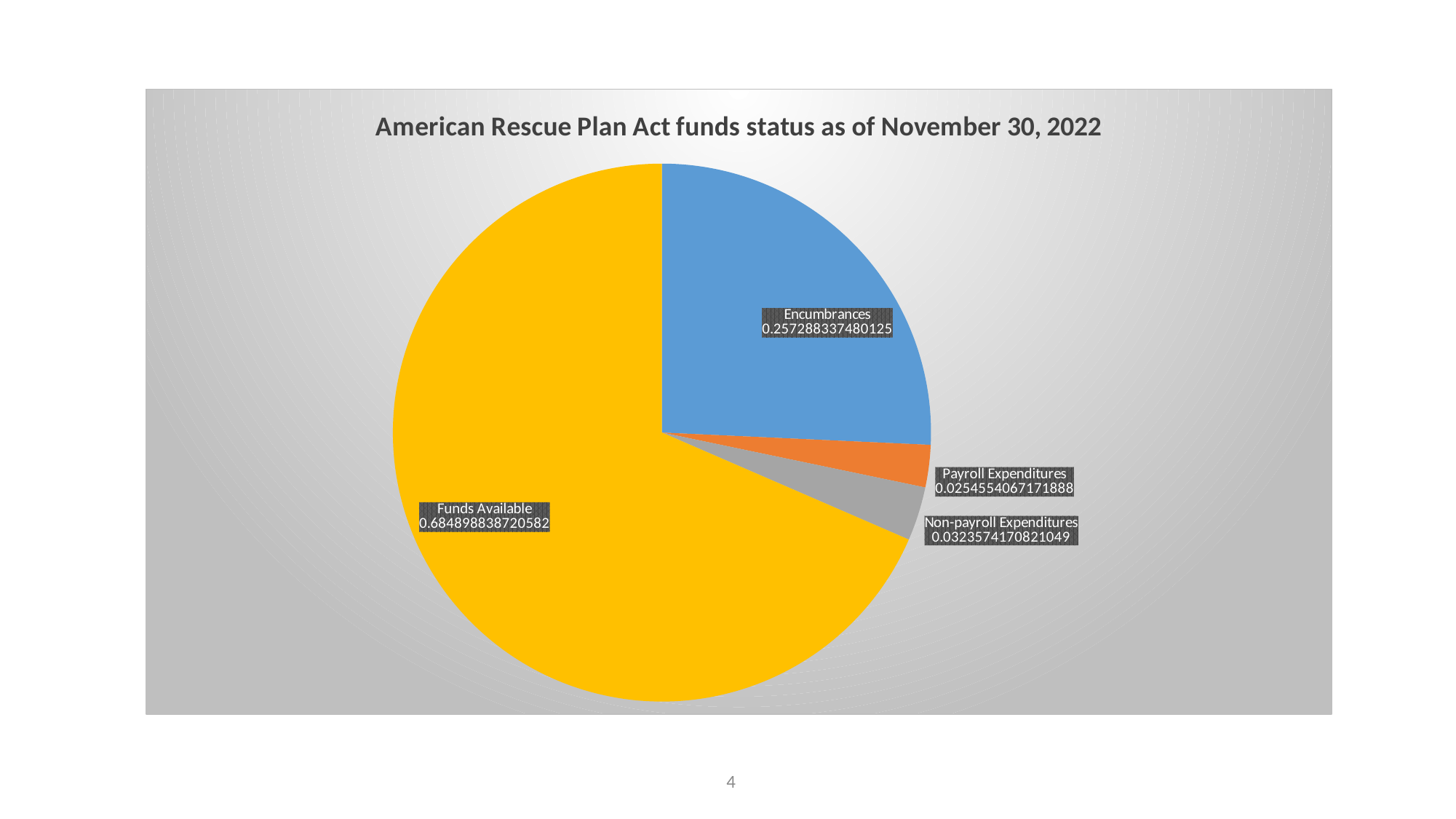
Which is larger, Non-payroll Expenditures or Payroll Expenditures? Non-payroll Expenditures Which category has the largest slice of the pie? Funds Available What colour is the Encumbrances slice? Blue What is the value shown for Encumbrances? 0.257288337480125 What is the title of the chart? American Rescue Plan Act funds status as of November 30, 2022 Which category has the smallest slice of the pie? Payroll Expenditures What type of chart is shown on the slide? Pie chart What is the value shown for Payroll Expenditures? 0.0254554067171888 What is the difference between the values for Funds Available and Encumbrances? 0.427610501240457 What is the value shown for Funds Available? 0.684898838720582 How many slices does the pie chart have? 4 What is the value shown for Non-payroll Expenditures? 0.0323574170821049